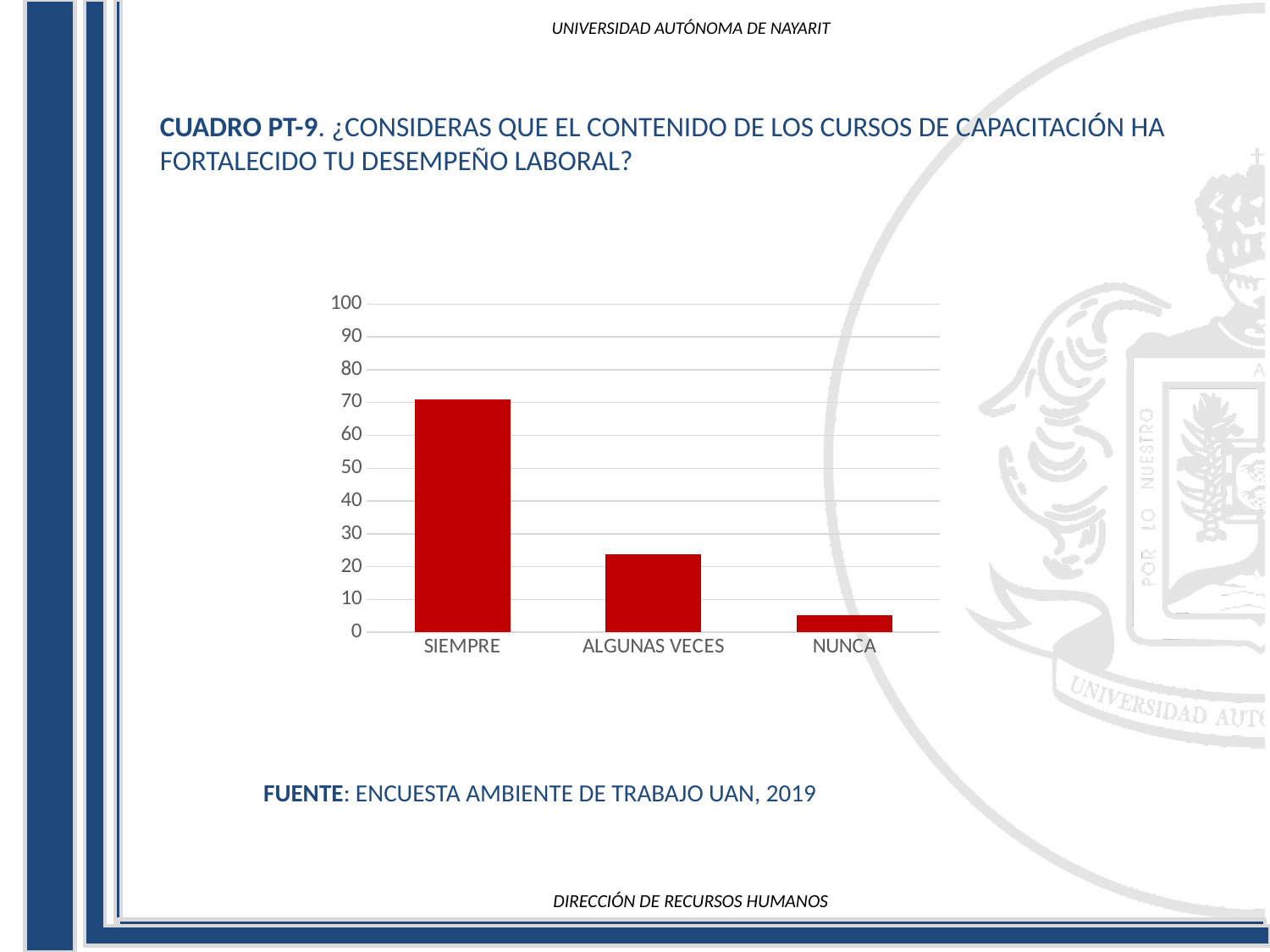
Is the value for ALGUNAS VECES greater or less than 30? less Which category has the highest bar? SIEMPRE What kind of chart is shown on the slide? bar chart Do the bar values rise or fall from left to right along the x axis? fall Is the value for SIEMPRE greater or less than 60? greater Is the value for NUNCA greater or less than 10? less Which category has the lowest bar? NUNCA How many categories are shown on the x axis of the chart? 3 Which is larger, the value for ALGUNAS VECES or the value for NUNCA? ALGUNAS VECES What colour are the bars in the chart? red